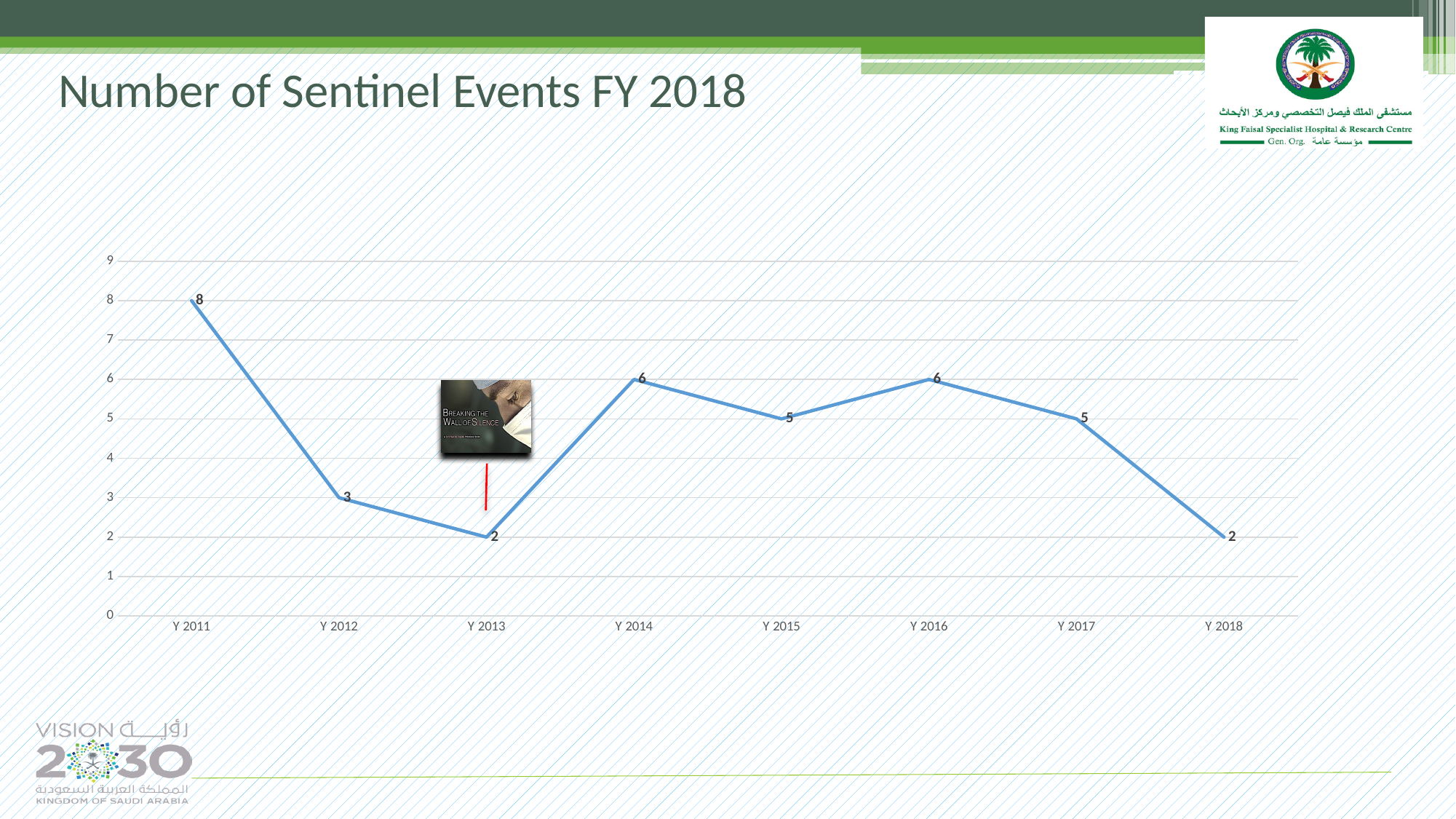
Which is larger, the value for Y 2014 or the value for Y 2015? Y 2014 What kind of chart is shown on the slide? line chart Which year has the highest number of sentinel events? Y 2011 What is the number of sentinel events for Y 2018? 2 What is the number of sentinel events for Y 2011? 8 What is the difference between the values for Y 2011 and Y 2012? 5 What is the title of the slide? Number of Sentinel Events FY 2018 What is the difference between the values for Y 2017 and Y 2018? 3 What is the number of sentinel events for Y 2013? 2 Do the values rise or fall from Y 2016 to Y 2018? fall How many years are plotted on the chart? 8 What is the number of sentinel events for Y 2016? 6